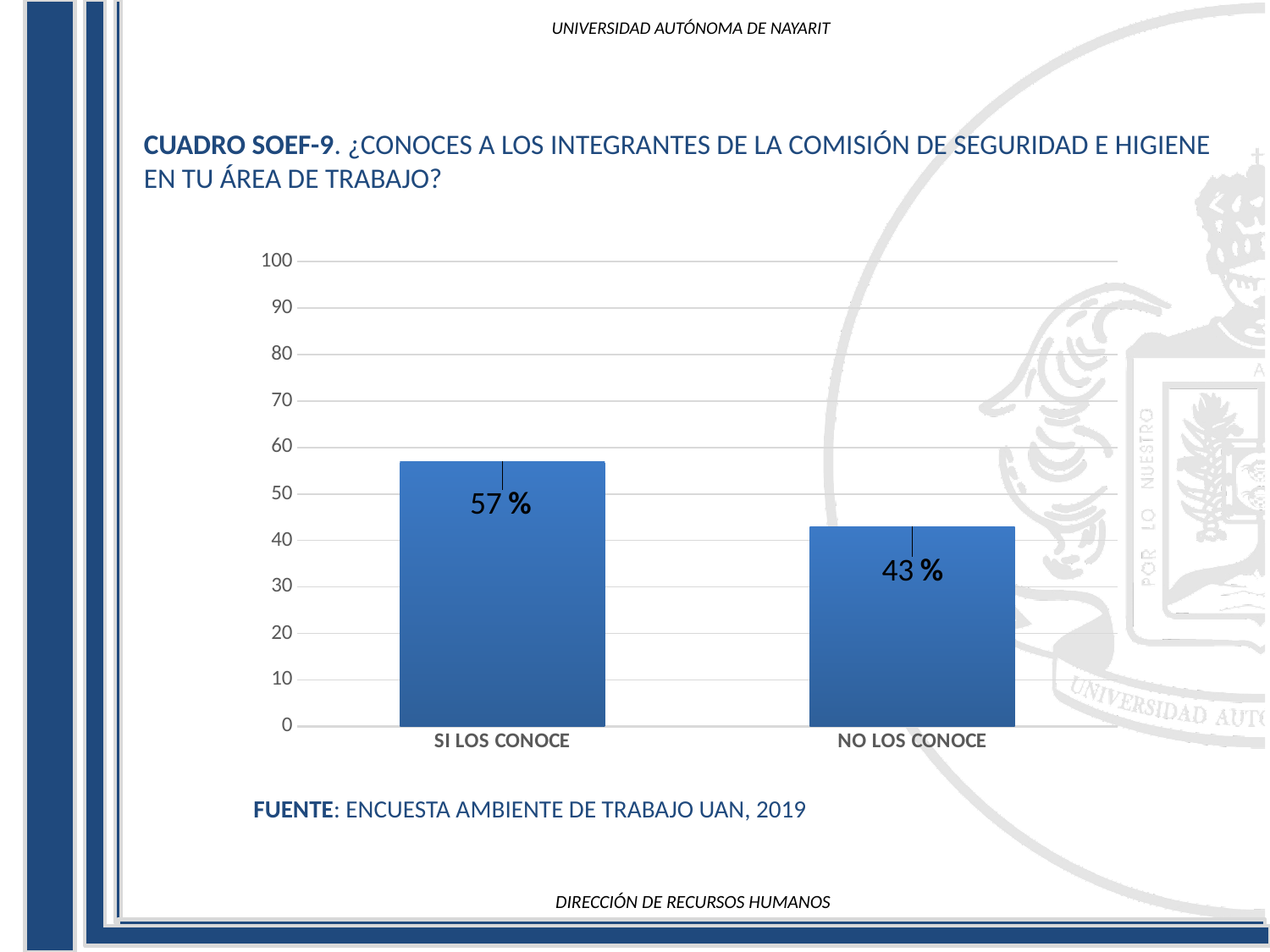
Which category has the lowest value? NO LOS CONOCE What source is cited below the chart? ENCUESTA AMBIENTE DE TRABAJO UAN, 2019 Which category has the highest value? SI LOS CONOCE How many categories are shown in the chart? 2 What kind of chart is shown on the slide? bar chart What is the value for SI LOS CONOCE? 57 % Is the value for SI LOS CONOCE greater or less than 50? greater What is the highest value shown on the vertical axis? 100 What is the value for NO LOS CONOCE? 43 % Is the value for NO LOS CONOCE greater or less than 50? less Which is larger, the value for SI LOS CONOCE or NO LOS CONOCE? SI LOS CONOCE What is the difference between the values for SI LOS CONOCE and NO LOS CONOCE? 14 %